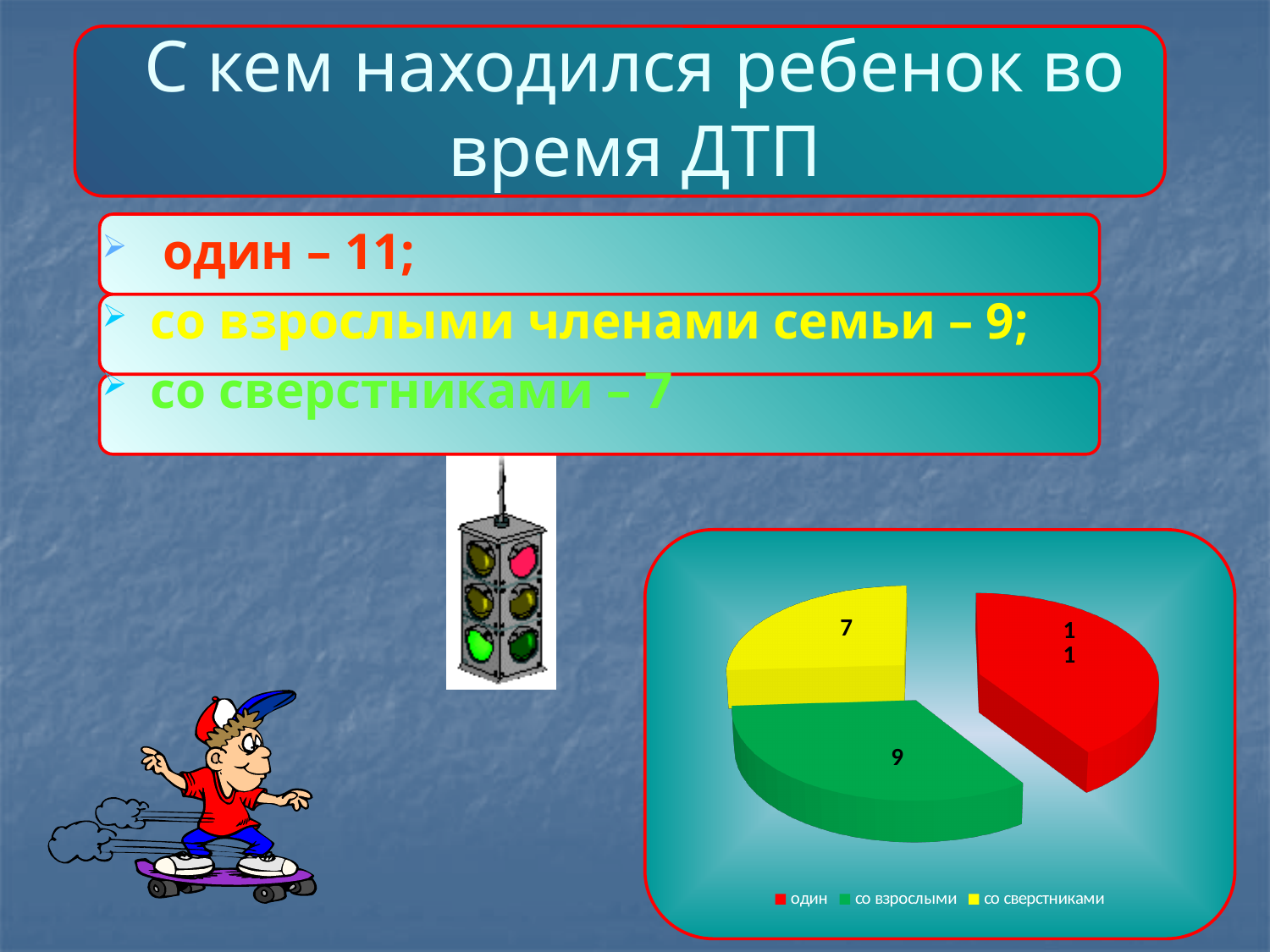
What colour is the "один" slice in the pie chart? red What kind of chart is shown on the slide? pie chart What is the value of the "один" slice in the pie chart? 11 Which category has the largest slice in the pie chart? один How many slices does the pie chart have? 3 What is the value of the "со сверстниками" slice in the pie chart? 7 What is the difference between the values for "один" and "со сверстниками"? 4 What is the total of all the values shown in the pie chart? 27 Which is larger, the value for "со взрослыми" or the value for "со сверстниками"? со взрослыми Which category has the smallest slice in the pie chart? со сверстниками What is the difference between the values for "один" and "со взрослыми"? 2 What is the value of the "со взрослыми" slice in the pie chart? 9